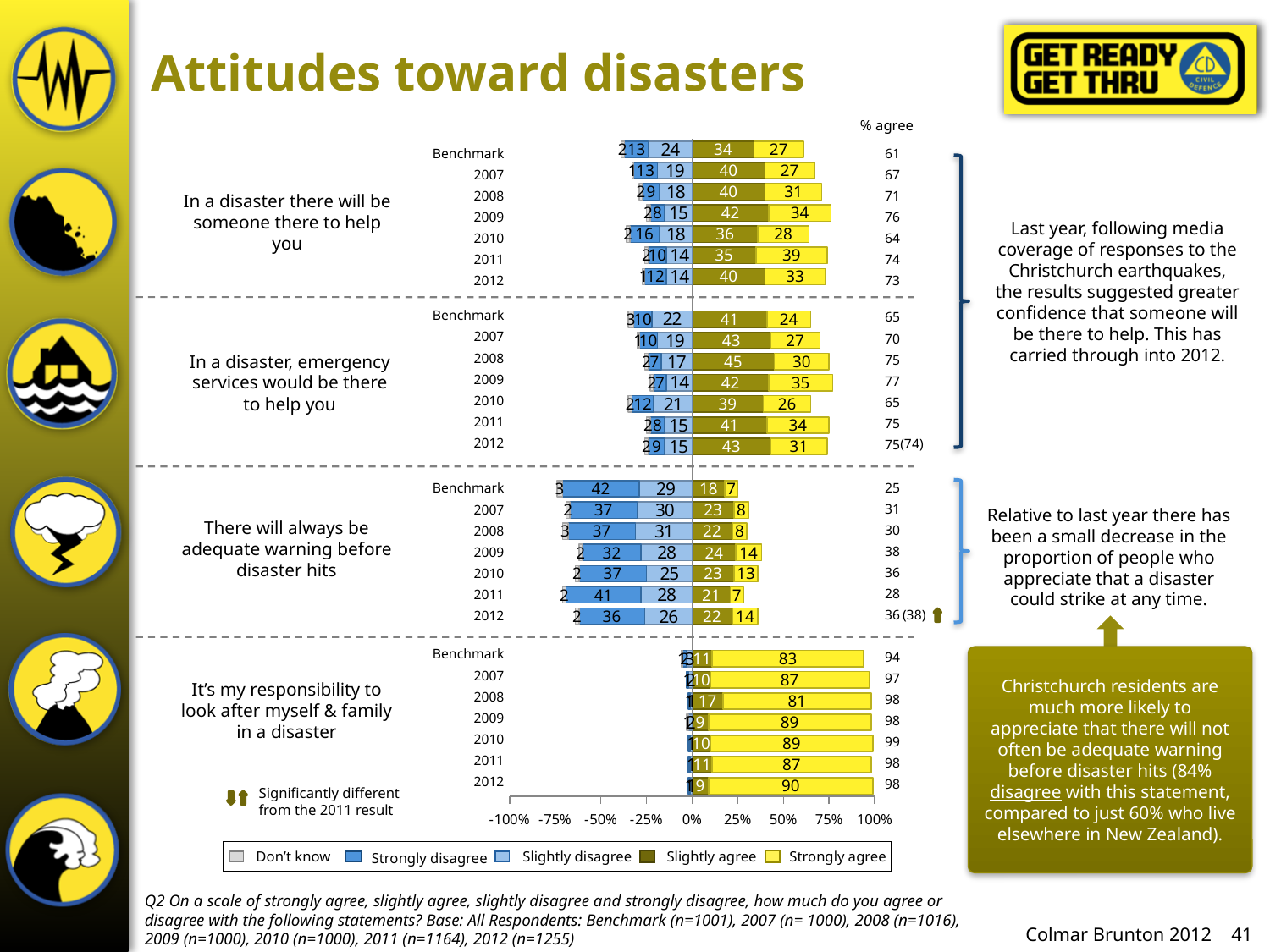
Which year has the highest % agree for "In a disaster, emergency services would be there to help you"? 2009 What is the % agree value for "It's my responsibility to look after myself & family in a disaster" in 2010? 99 What kind of chart is shown on the slide? Stacked bar chart Which row has the lowest % agree for "There will always be adequate warning before disaster hits"? Benchmark Does the % agree for "It's my responsibility to look after myself & family in a disaster" rise or fall from Benchmark to 2010? Rise For "There will always be adequate warning before disaster hits", is the strongly disagree percentage larger in the Benchmark row or in 2012? Benchmark How many rows (Benchmark plus years) are plotted for each statement? 7 For "In a disaster there will be someone there to help you", how much higher is the strongly agree percentage in 2011 than in 2010? 11 What is the % agree value for "In a disaster there will be someone there to help you" in 2009? 76 What percentage slightly agree with "In a disaster, emergency services would be there to help you" in 2008? 45 What percentage strongly agree with "It's my responsibility to look after myself & family in a disaster" in 2012? 90 How many response categories does the legend list? 5